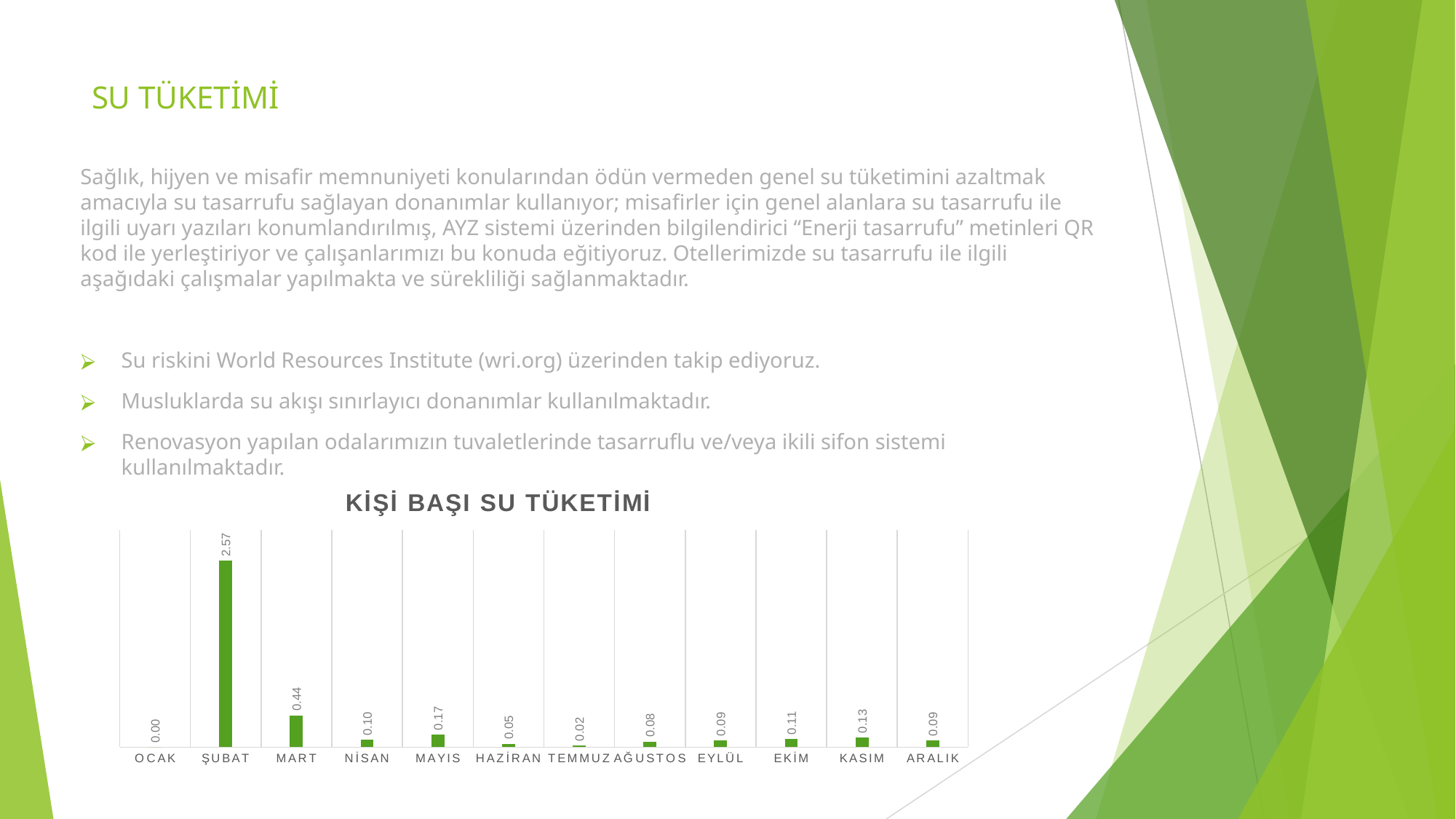
What is the value for ŞUBAT? 2.57 What is the value for KASIM? 0.13 Which is larger, the value for MAYIS or the value for NİSAN? MAYIS What kind of chart is shown on the slide? bar chart What is the value for MART? 0.44 Which month has the highest value? ŞUBAT Which month has the lowest value? OCAK How many categories (months) are shown on the x axis of the chart? 12 What is the difference between the values for ŞUBAT and MART? 2.13 What is the value for TEMMUZ? 0.02 What is the title of the chart? KİŞİ BAŞI SU TÜKETİMİ What is the difference between the values for KASIM and ARALIK? 0.04